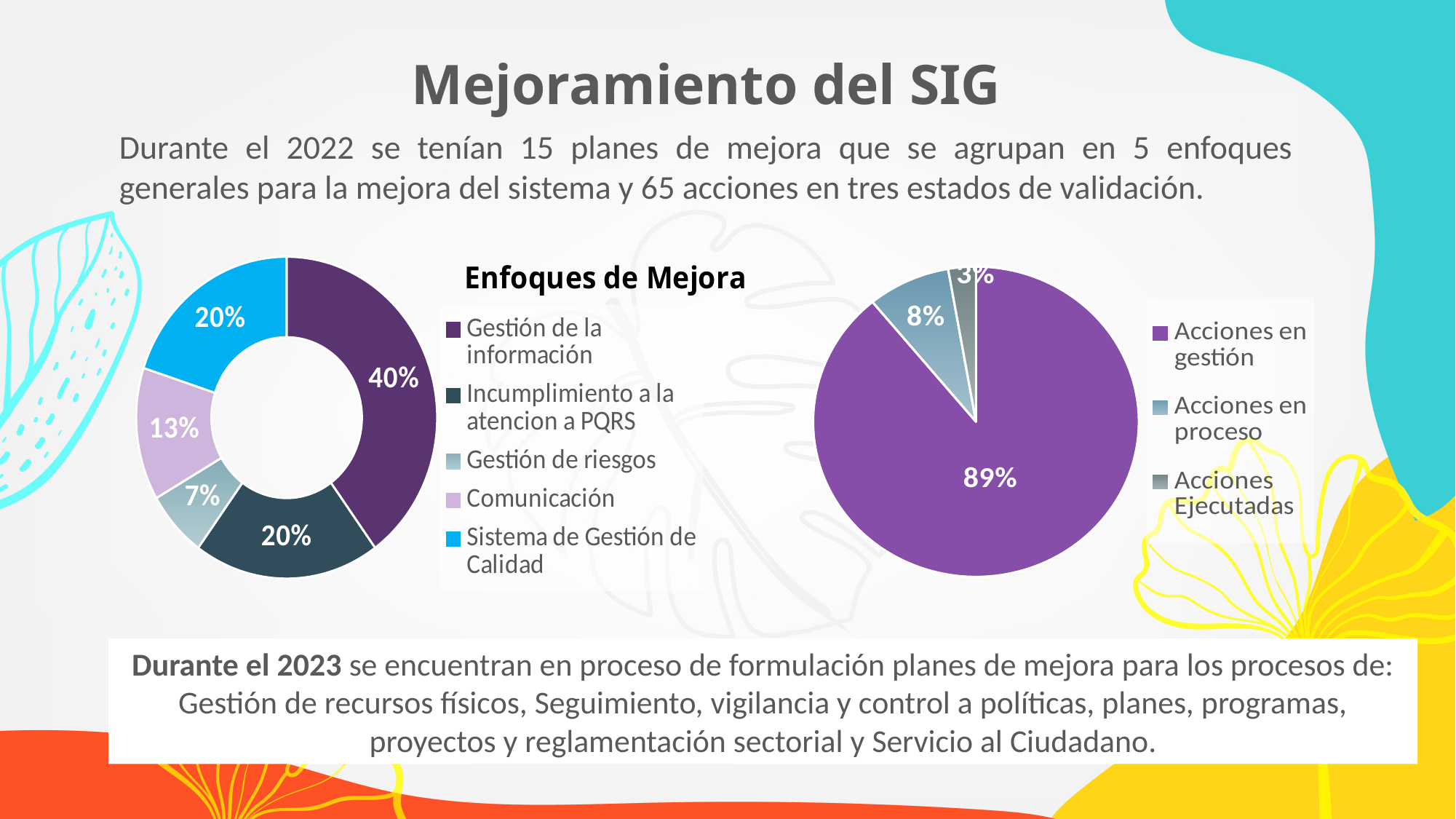
In the pie chart on the right, how many entries does the legend list? 3 In the 'Enfoques de Mejora' chart, what is the difference in percentage points between 'Gestión de la información' and 'Comunicación'? 27 In the pie chart on the right, what share do 'Acciones Ejecutadas' have? 3% In the pie chart on the right, which is larger: 'Acciones en proceso' or 'Acciones Ejecutadas'? Acciones en proceso In the 'Enfoques de Mejora' chart, what share does 'Comunicación' have? 13% In the 'Enfoques de Mejora' chart, what share does 'Gestión de la información' have? 40% In the 'Enfoques de Mejora' chart, which category has the smallest share? Gestión de riesgos In the pie chart on the right, what share do 'Acciones en gestión' have? 89% In the 'Enfoques de Mejora' chart, how many categories are shown? 5 What kind of chart is the 'Enfoques de Mejora' chart? Doughnut chart In the 'Enfoques de Mejora' chart, which category has the largest share? Gestión de la información In the 'Enfoques de Mejora' chart, what share does 'Gestión de riesgos' have? 7%